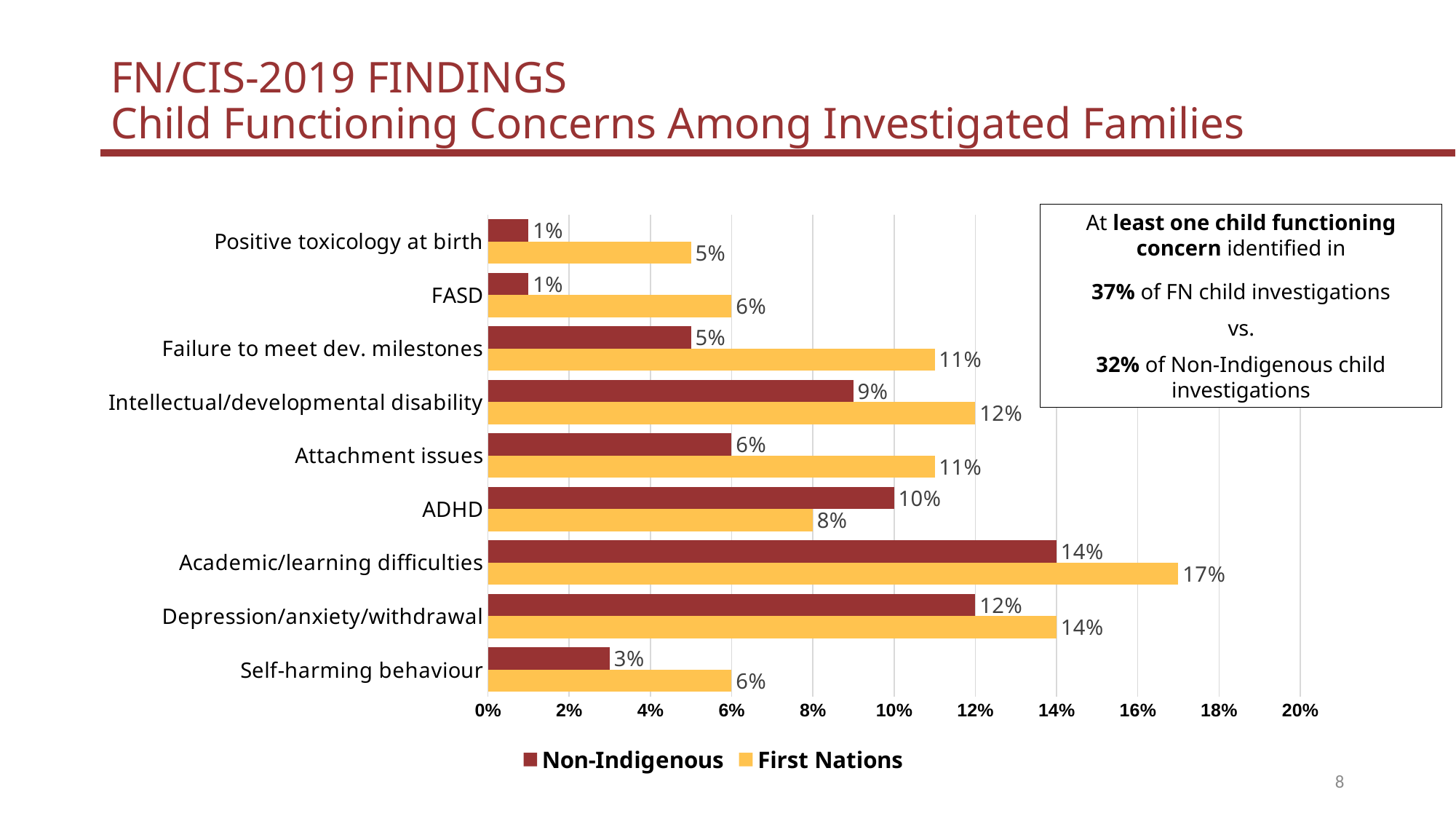
How many series does the legend list? 2 What is the difference between the First Nations and Non-Indigenous values for Attachment issues? 5% What is the Non-Indigenous value for Self-harming behaviour? 3% What kind of chart is shown on the slide? Bar chart What is the First Nations value for Failure to meet dev. milestones? 11% Which category has the lowest First Nations value? Positive toxicology at birth What is the First Nations value for Academic/learning difficulties? 17% Which series is shown in yellow/orange in the legend? First Nations Which category has the highest First Nations value? Academic/learning difficulties What is the Non-Indigenous value for ADHD? 10% How many categories are shown on the chart? 9 Which is larger for ADHD, the Non-Indigenous value or the First Nations value? Non-Indigenous